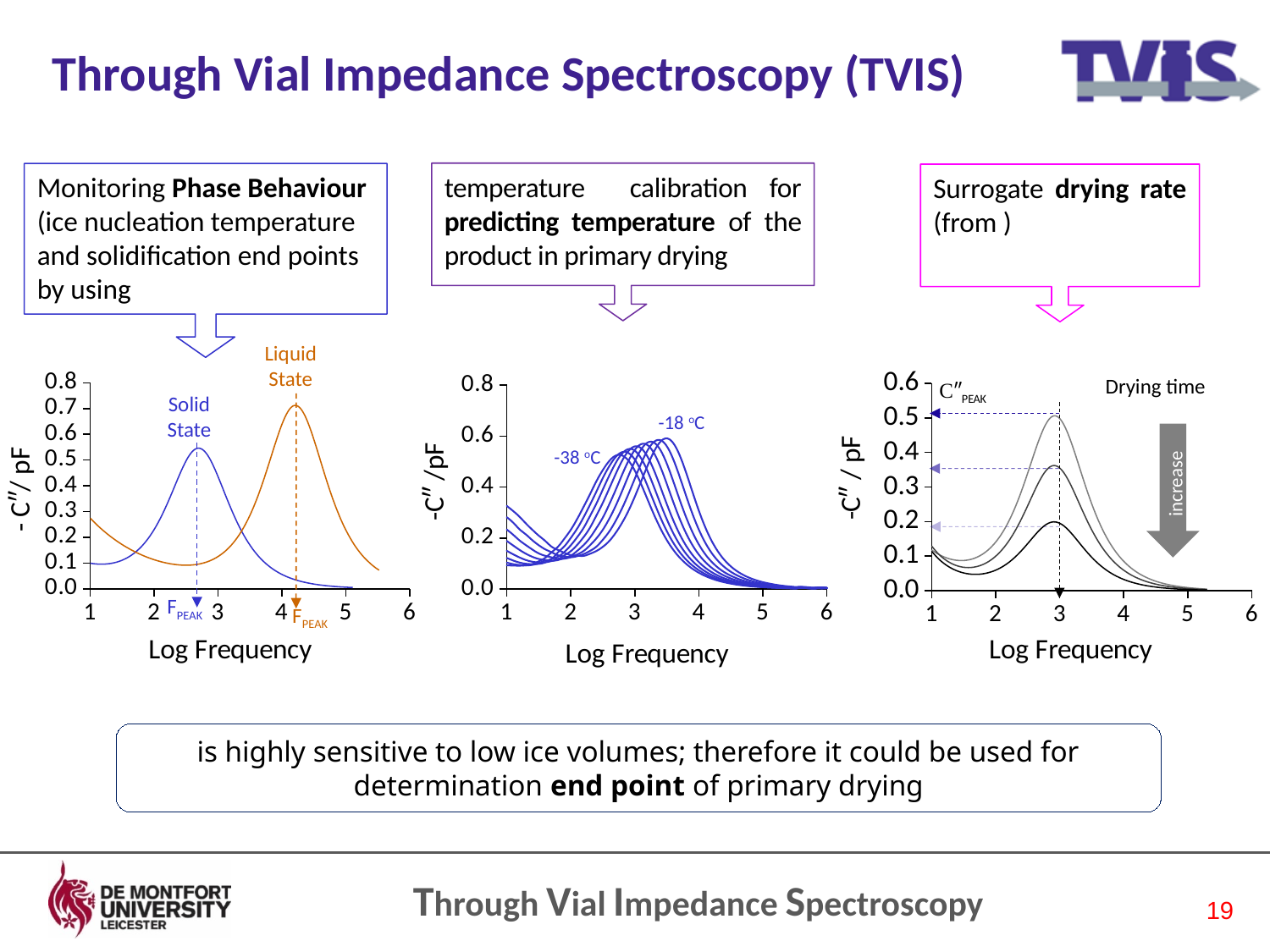
What kind of chart is the left chart showing the Solid State and Liquid State curves? line chart What is the x-axis title of the left chart? Log Frequency What is the maximum value shown on the y-axis of the right chart? 0.6 How many curves are plotted in the right chart (Drying time)? 3 In the right chart, is the peak value of the lowest curve greater or less than 0.3? less In the left chart, which curve reaches the higher peak, Solid State or Liquid State? Liquid State In the left chart, is the peak value of the Liquid State curve greater or less than 0.6? greater In the middle chart, is the peak value of the -18 °C curve greater or less than 0.4? greater In the right chart, at what log frequency do the peaks of the curves occur, as marked by the dashed vertical line? 3 In the middle chart, what are the two temperatures labelled on the curves? -38 °C and -18 °C